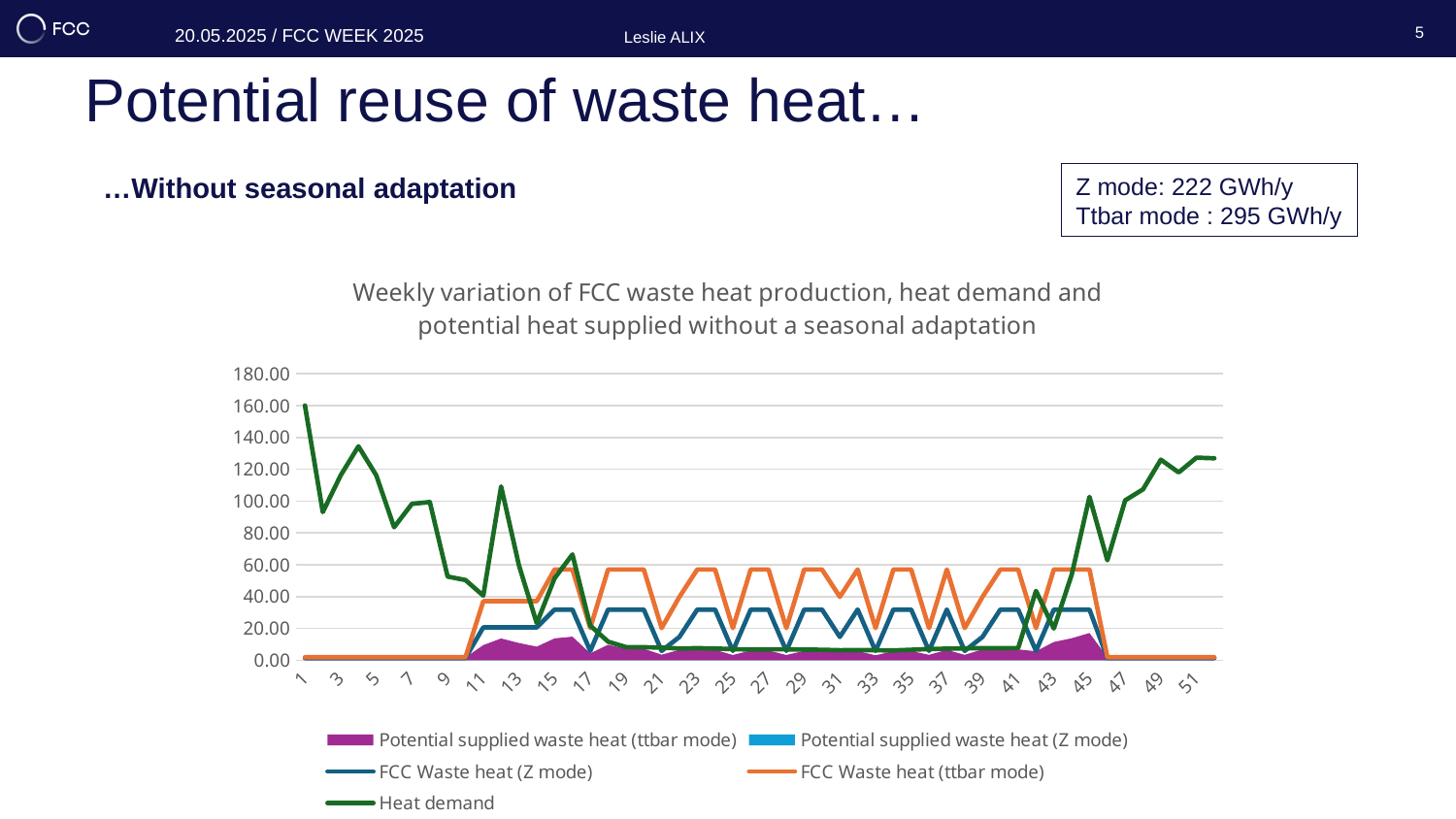
Is the highest value reached by FCC Waste heat (ttbar mode) greater or less than 80? less Is the Heat demand value at week 25 greater or less than 40? less At week 1, which is larger: Heat demand or FCC Waste heat (ttbar mode)? Heat demand Is the Heat demand value at week 51 greater or less than 100? greater Which series reaches the highest value on the chart? Heat demand What kind of chart is shown on the slide? combination area and line chart At week 19, which is larger: FCC Waste heat (ttbar mode) or FCC Waste heat (Z mode)? FCC Waste heat (ttbar mode) What is the title of the chart? Weekly variation of FCC waste heat production, heat demand and potential heat supplied without a seasonal adaptation How many series does the chart legend list? 5 Does the Heat demand series rise or fall from week 1 to week 25? fall